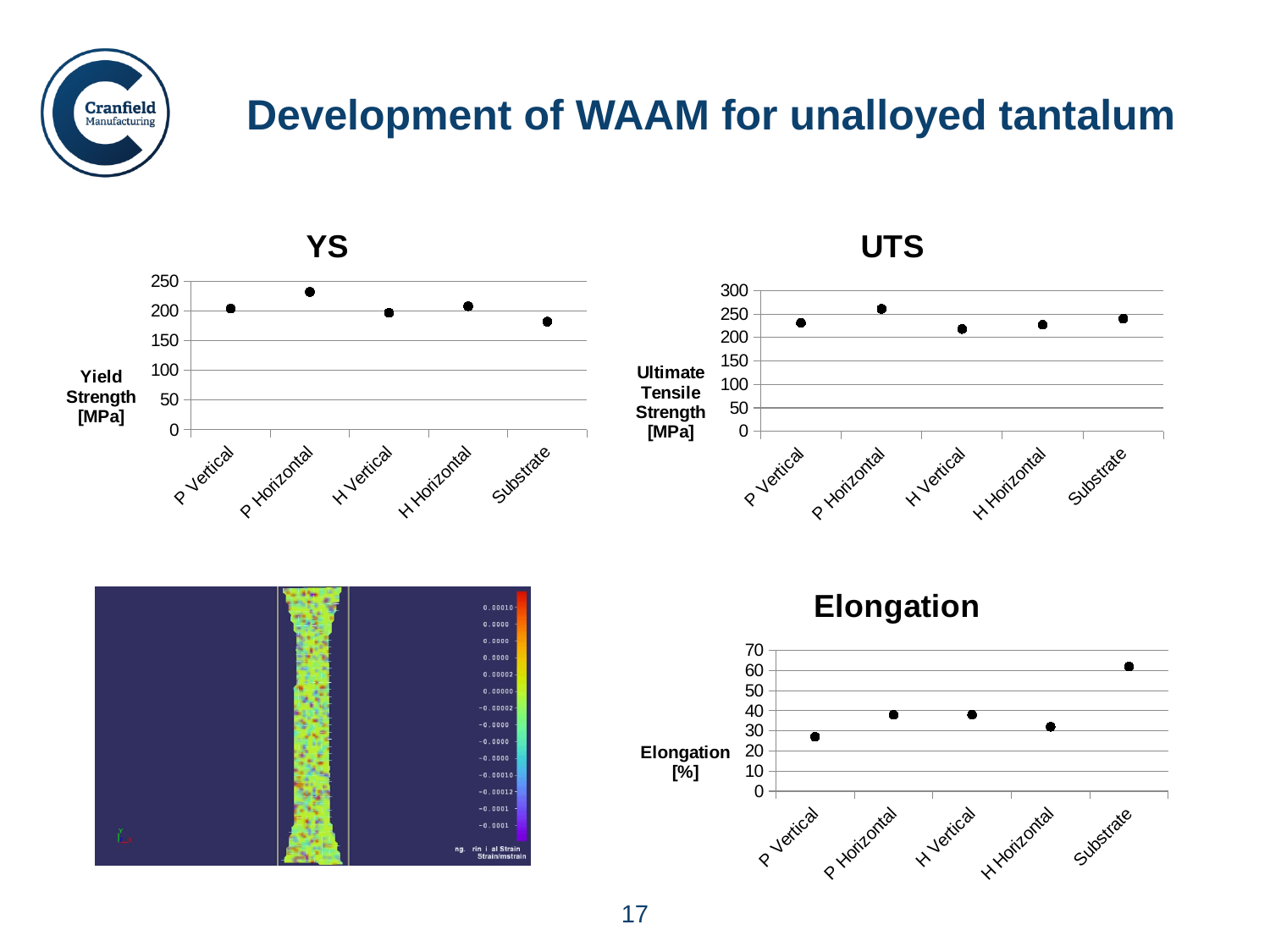
In the YS chart, is the value for Substrate greater or less than 200? less In the UTS chart, is the value for P Horizontal greater or less than 250? greater In the YS chart, which category has the lowest yield strength? Substrate In the Elongation chart, which category has the highest elongation? Substrate In the YS chart, which category has the highest yield strength? P Horizontal In the Elongation chart, is the value for Substrate greater or less than 50? greater What is the y-axis label of the UTS chart? Ultimate Tensile Strength [MPa] How many categories are plotted on the x axis of the Elongation chart? 5 In the Elongation chart, which category has the lowest elongation? P Vertical In the UTS chart, which category has the highest ultimate tensile strength? P Horizontal